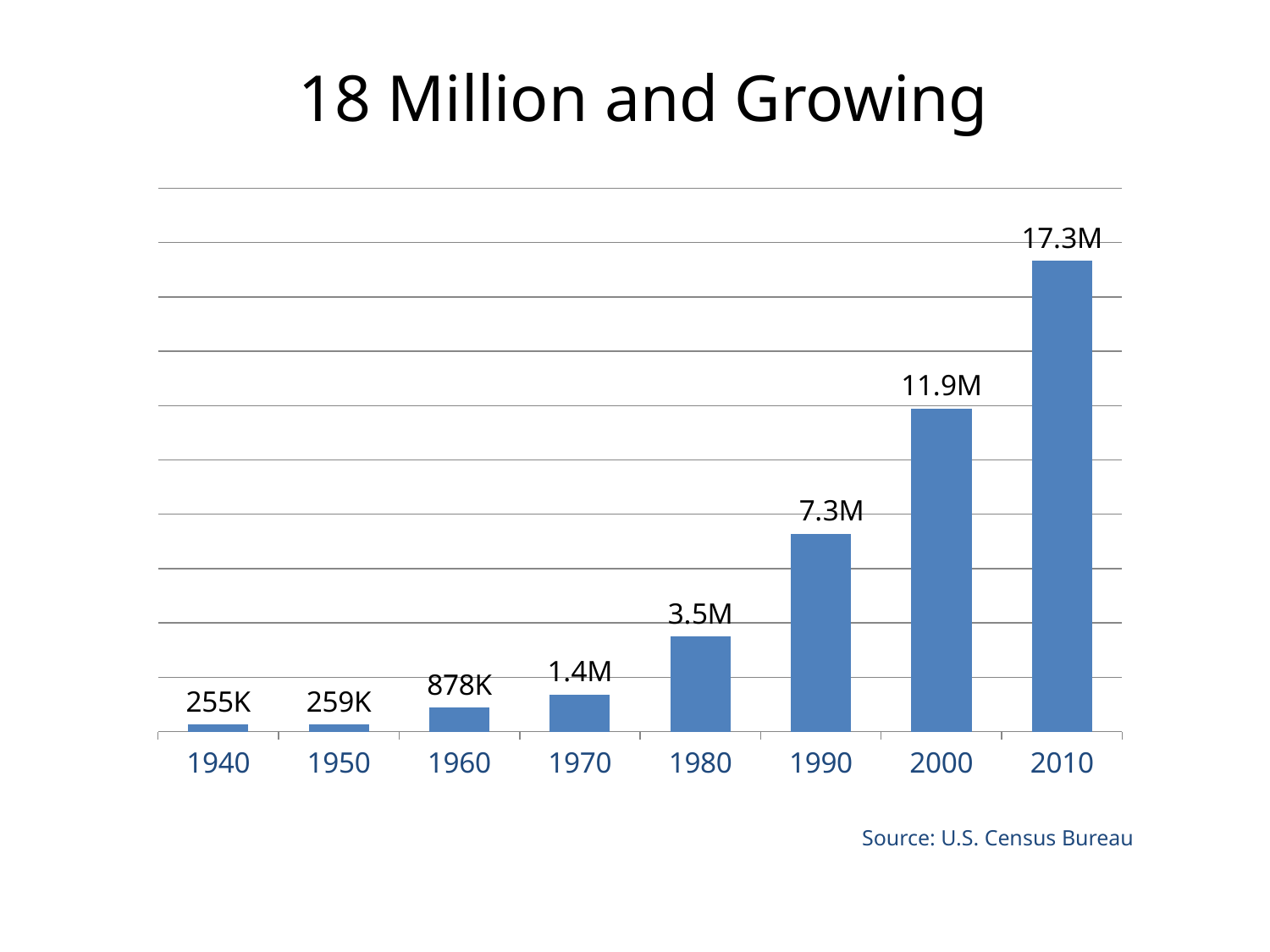
What is the value for 1940? 255K Which year has the highest value? 2010 What is the difference between the values for 1950 and 1940? 4K What is the value for 2010? 17.3M What is the value for 1960? 878K What is the value for 1990? 7.3M Which year has the lowest value? 1940 What is the difference between the values for 2010 and 2000? 5.4M What kind of chart is this? bar chart Do the values rise or fall from 1940 to 2010? rise Which is larger, the value for 1980 or the value for 1990? 1990 How many years are shown on the x axis? 8